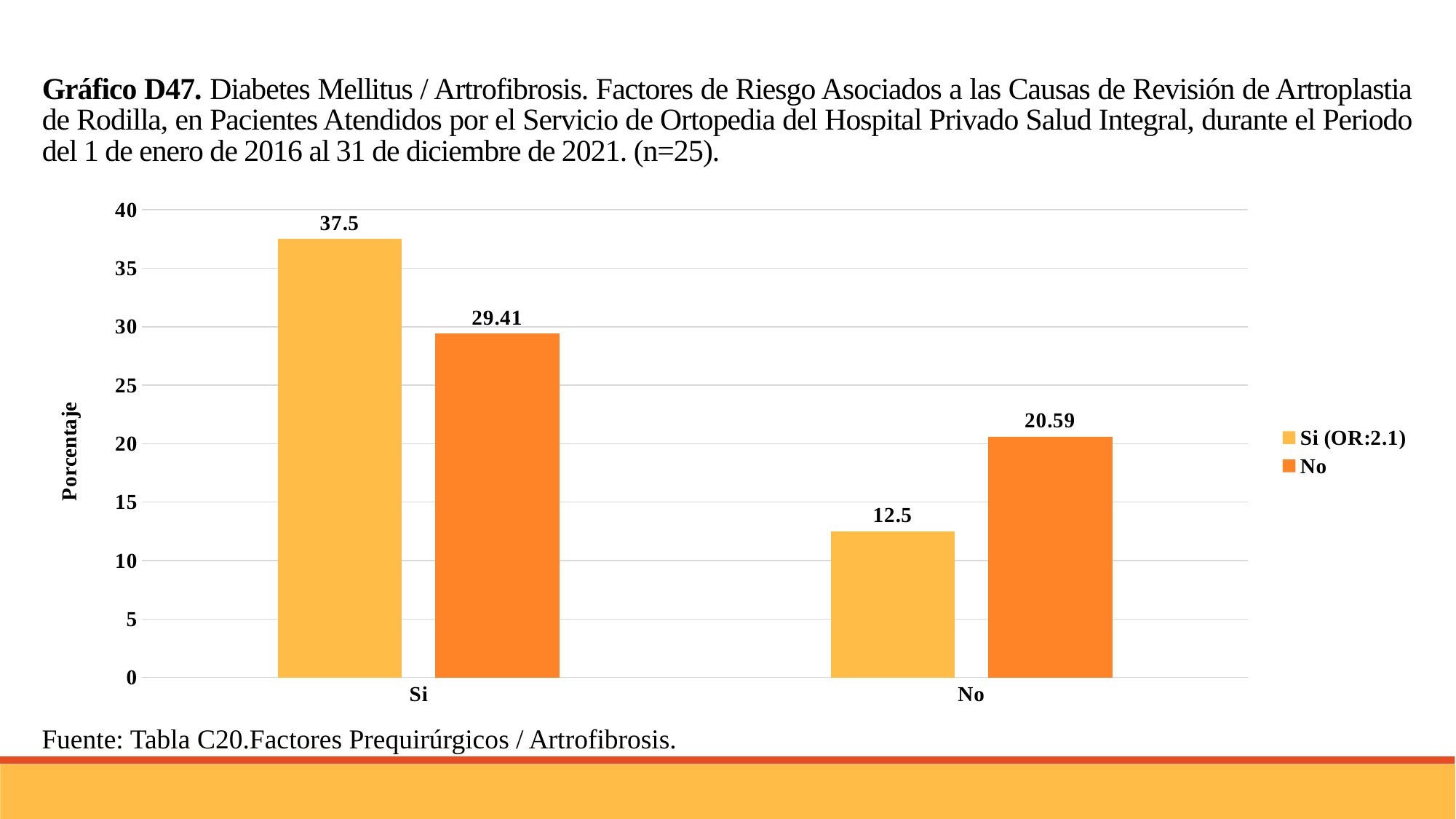
What is the value of the 'Si (OR:2.1)' series for the 'No' category? 12.5 Which bar has the lowest value in the chart? Si (OR:2.1) for No Which bar has the highest value in the chart? Si (OR:2.1) for Si How many series does the legend list? 2 What is the difference between the 'Si (OR:2.1)' and 'No' series values for the 'Si' category? 8.09 How many categories are shown on the x axis? 2 What is the value of the 'No' series for the 'Si' category? 29.41 What is the value of the 'No' series for the 'No' category? 20.59 What is the label of the vertical axis? Porcentaje For the 'No' category, which series has the larger value, 'Si (OR:2.1)' or 'No'? No What is the value of the 'Si (OR:2.1)' series for the 'Si' category? 37.5 What kind of chart is shown on the slide? Bar chart